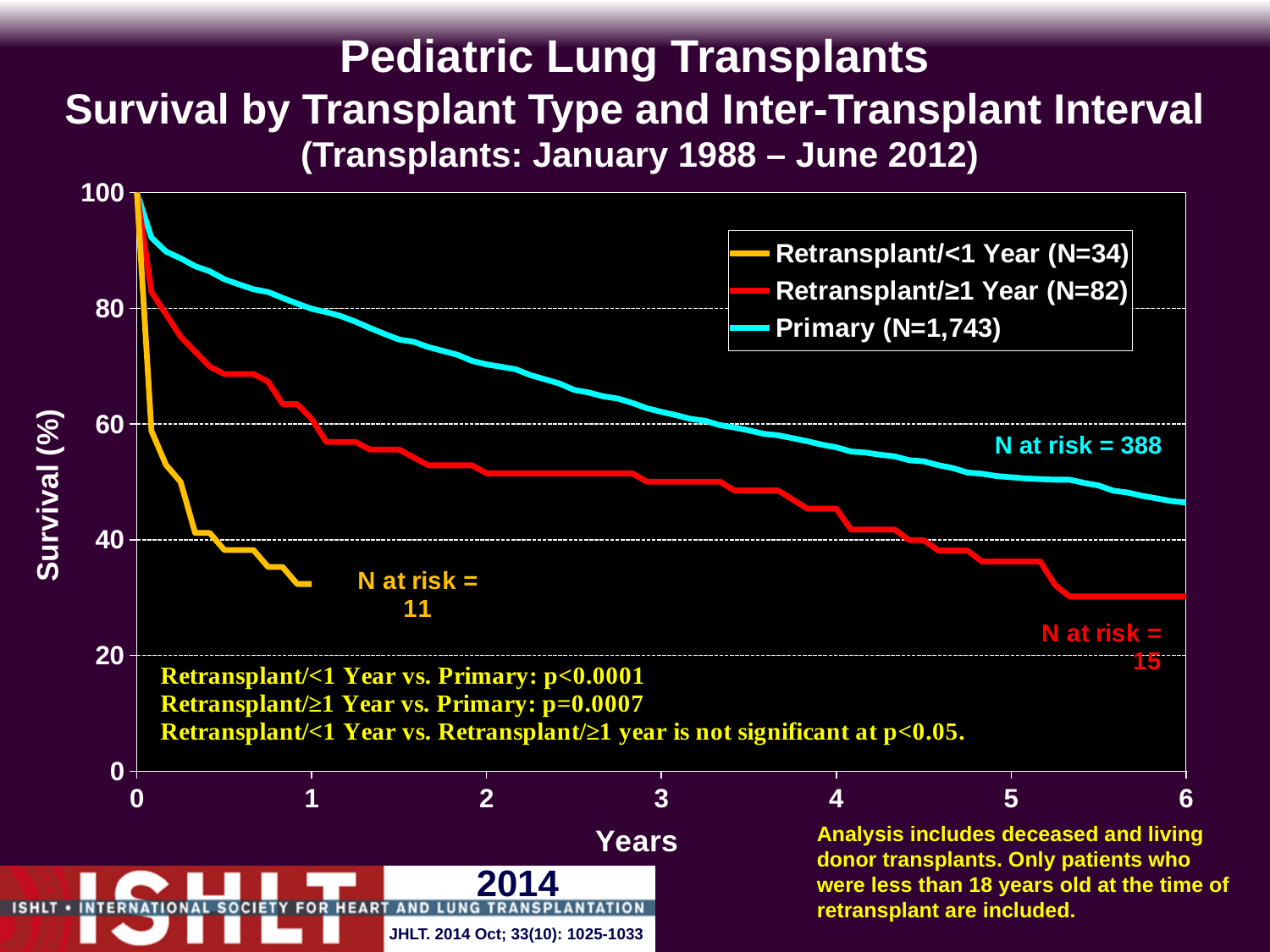
Which series has the lowest survival curve on the chart? Retransplant/<1 Year Is the survival value for Retransplant/≥1 Year at 6 years greater or less than 40? less According to the legend, how many patients are in the Primary group? N=1,743 What is the label on the y axis of the chart? Survival (%) What is the N at risk shown for the Primary series? 388 What is the N at risk shown for the Retransplant/≥1 Year series? 15 What kind of chart is shown on the slide? line chart What is the N at risk shown for the Retransplant/<1 Year series? 11 Is the survival value for Primary at 6 years greater or less than 60? less At 6 years, which series has higher survival: Primary or Retransplant/≥1 Year? Primary How many series does the legend list? 3 Do the survival curves rise or fall as years increase? fall